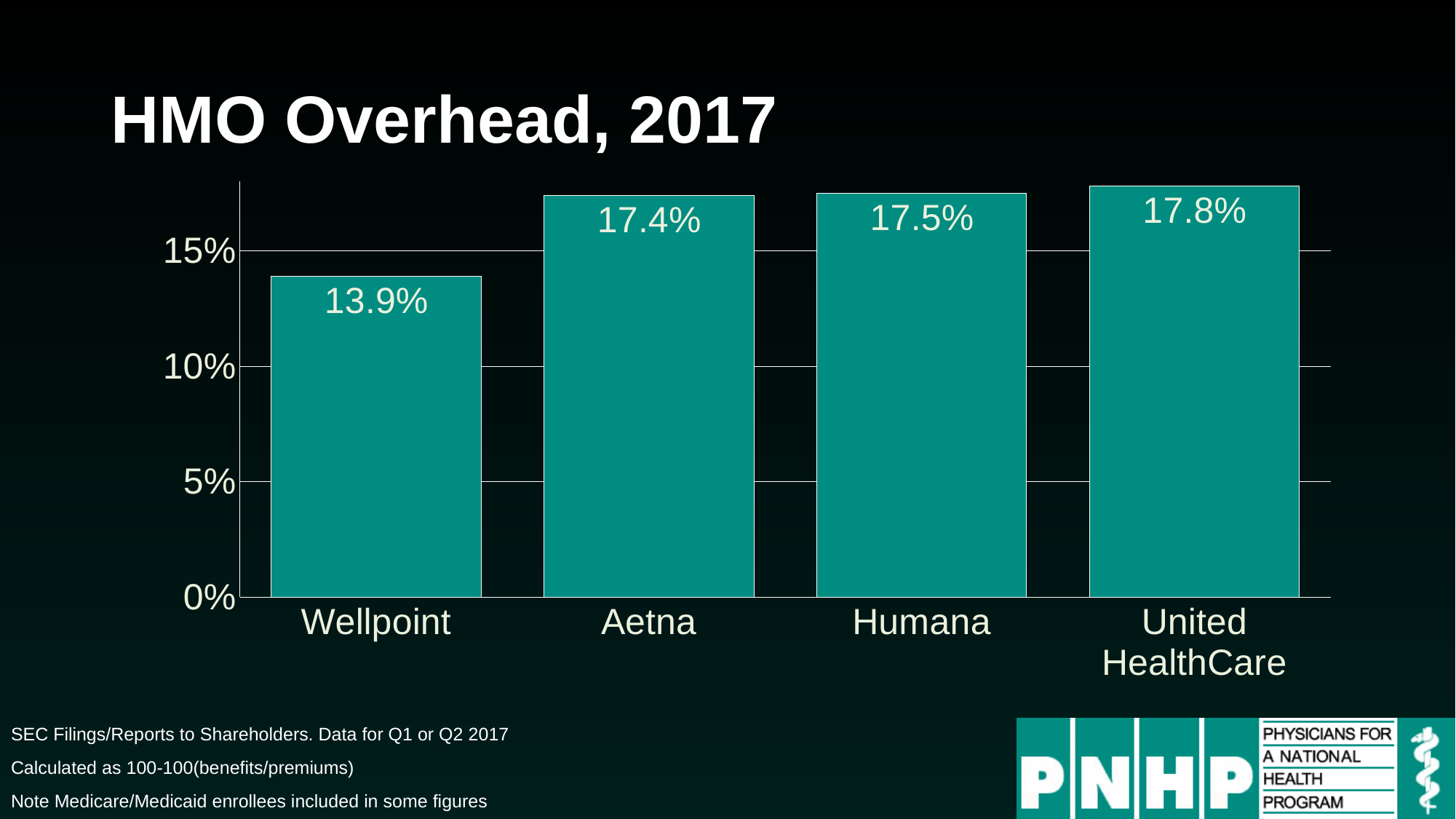
What is the difference between the overhead of United HealthCare and Wellpoint? 3.9% What is the overhead value for Aetna? 17.4% Which has a higher overhead, Wellpoint or Aetna? Aetna What is the overhead value for Humana? 17.5% What kind of chart is shown on the slide? bar chart Which company has the highest overhead? United HealthCare How many companies are shown in the chart? 4 What is the title of the chart? HMO Overhead, 2017 What is the overhead value for United HealthCare? 17.8% Is the value for Wellpoint greater or less than 15%? less Which company has the lowest overhead? Wellpoint What is the overhead value for Wellpoint? 13.9%